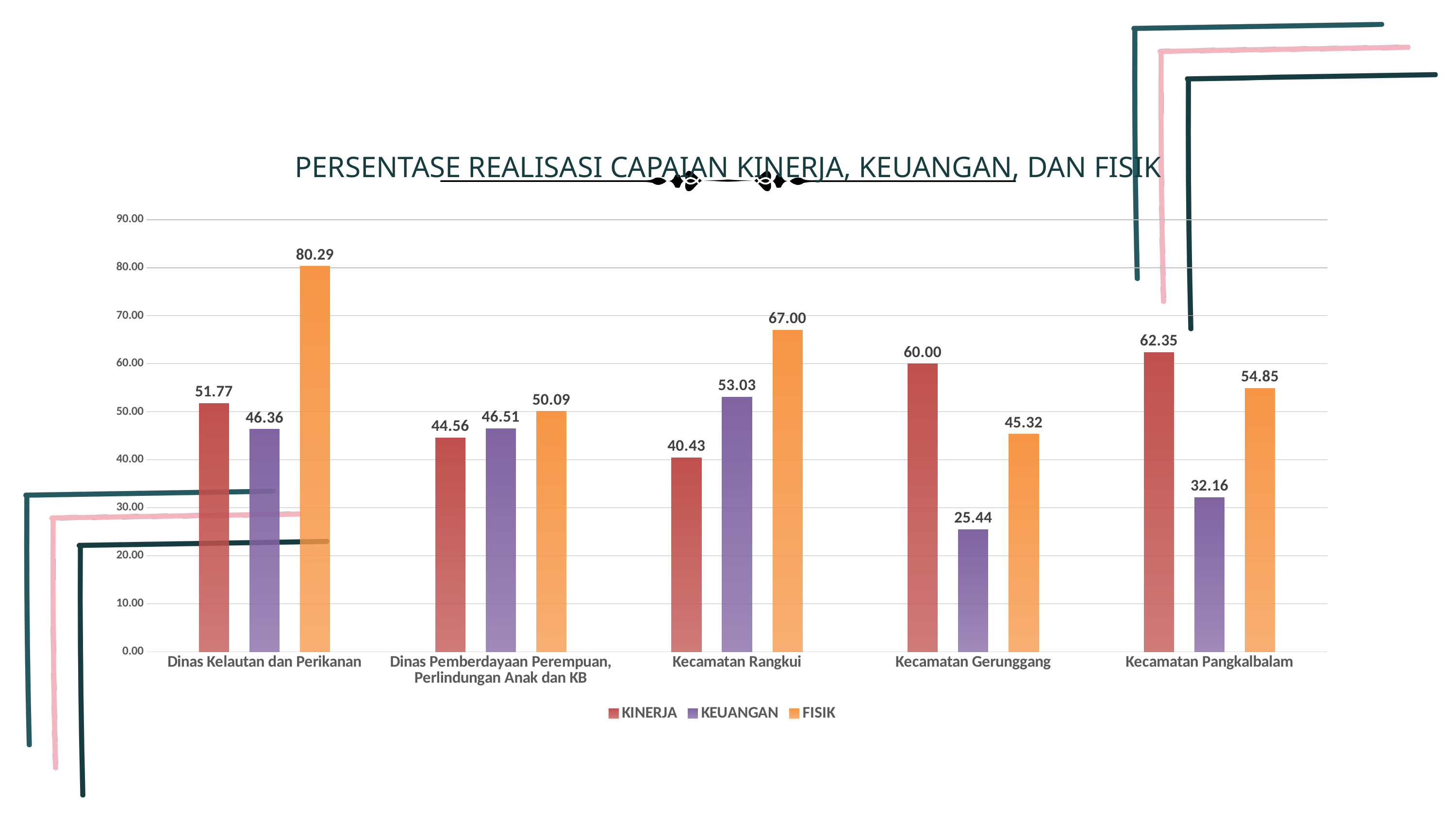
Which category has the lowest KINERJA value? Kecamatan Rangkui What is the KINERJA value for Kecamatan Pangkalbalam? 62.35 Which series is shown in orange in the legend? FISIK What is the title of the chart? PERSENTASE REALISASI CAPAIAN KINERJA, KEUANGAN, DAN FISIK Which category has the highest FISIK value? Dinas Kelautan dan Perikanan What is the difference between the FISIK and KINERJA values for Kecamatan Rangkui? 26.57 What kind of chart is shown on the slide? Bar chart How many series does the legend list? 3 What is the KEUANGAN value for Kecamatan Gerunggang? 25.44 Which is larger for Kecamatan Gerunggang, the KINERJA value or the FISIK value? KINERJA How many categories are shown on the x axis? 5 What is the FISIK value for Dinas Kelautan dan Perikanan? 80.29